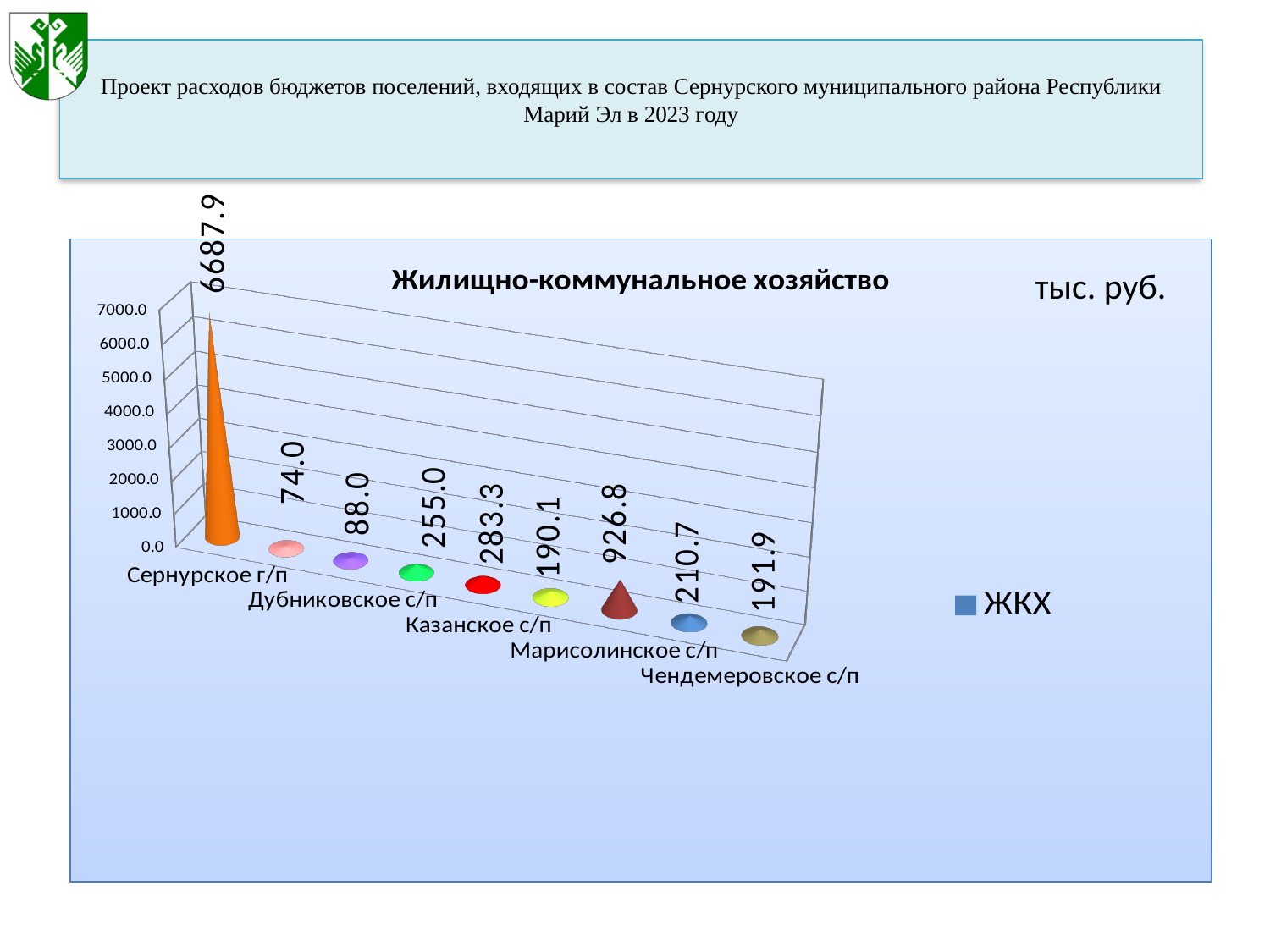
What is the value for Чендемеровское с/п? 191.9 Is the value for Сернурское г/п greater or less than 6000? greater What is the difference between the values for Марисолинское с/п and Чендемеровское с/п? 734.9 Which is larger, the value for Казанское с/п or Дубниковское с/п? Казанское с/п Which category has the highest value? Сернурское г/п How many series does the legend list? 1 How many data points are plotted on the chart? 9 What is the value for Марисолинское с/п? 926.8 What is the value for Казанское с/п? 283.3 What is the value for Сернурское г/п? 6687.9 What is the title of the chart? Жилищно-коммунальное хозяйство What is the lowest value shown on the chart? 74.0